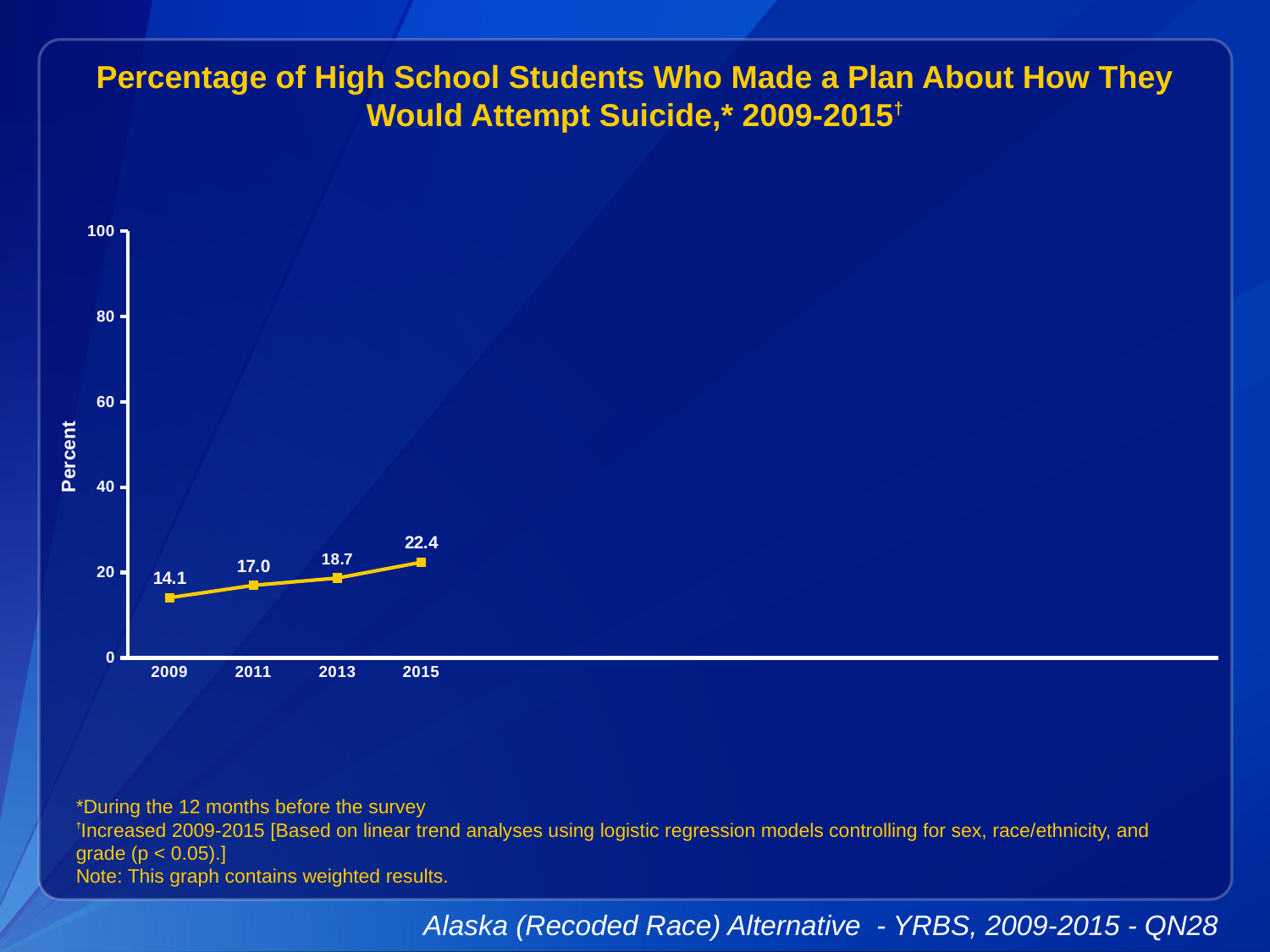
Which year has the lowest value? 2009 How many years are plotted on the chart? 4 What is the value for 2009? 14.1 Which is larger, the value for 2011 or the value for 2013? 2013 Do the values rise or fall from 2009 to 2015? rise What kind of chart is shown? line chart Which year has the highest value? 2015 What is the difference between the values for 2015 and 2009? 8.3 What is the value for 2015? 22.4 Is the value for 2015 greater or less than 20? greater What is the value for 2011? 17.0 What is the value for 2013? 18.7